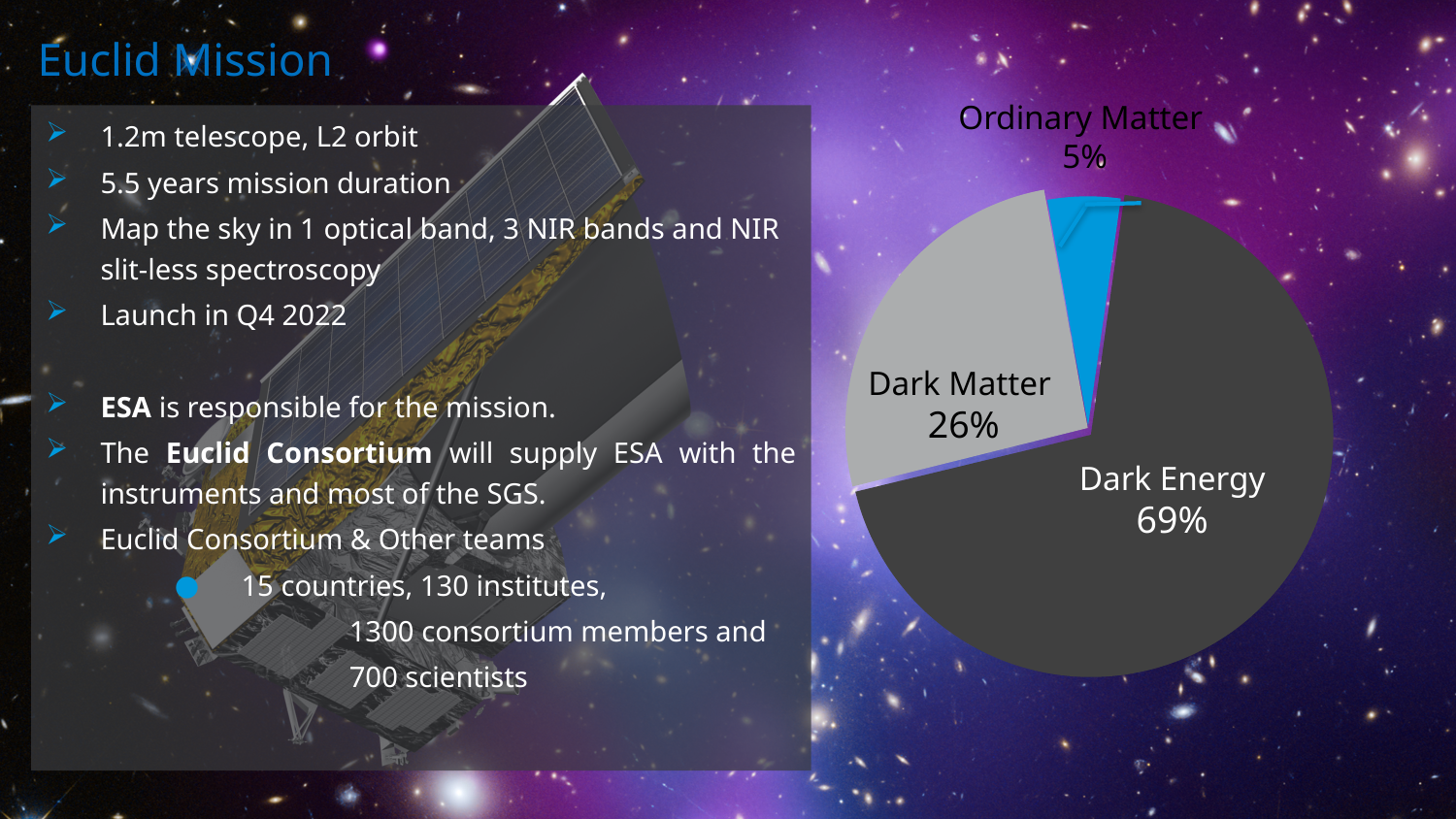
What share of the pie does Dark Matter have? 26% What is the difference in percentage points between Dark Matter and Ordinary Matter? 21 Which slice of the pie chart is the largest? Dark Energy How many slices does the pie chart have? 3 Which slice of the pie chart is the smallest? Ordinary Matter What colour is the Dark Energy slice in the pie chart? dark grey What share of the pie does Dark Energy have? 69% What share of the pie does Ordinary Matter have? 5% Which is larger, the Dark Matter slice or the Ordinary Matter slice? Dark Matter What colour is the Ordinary Matter slice in the pie chart? blue What kind of chart is shown on the slide? pie chart What is the difference in percentage points between Dark Energy and Dark Matter? 43